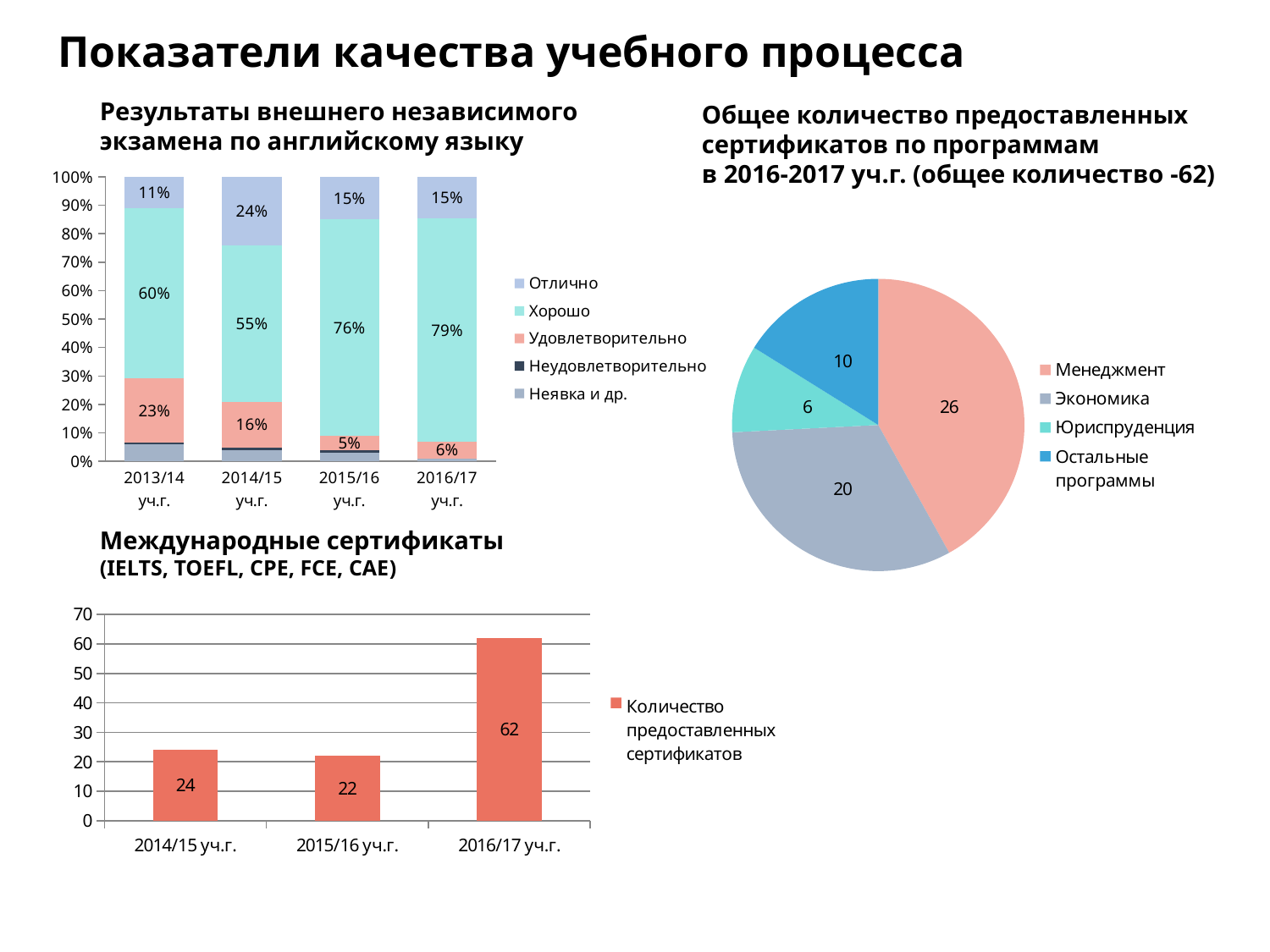
In the chart 'Результаты внешнего независимого экзамена по английскому языку', what is the difference between the 'Удовлетворительно' values for 2013/14 уч.г. and 2014/15 уч.г.? 7% In the pie chart 'Общее количество предоставленных сертификатов по программам', which program has the smallest slice? Юриспруденция In the chart 'Результаты внешнего независимого экзамена по английскому языку', what percentage is labelled 'Отлично' for 2014/15 уч.г.? 24% In the pie chart 'Общее количество предоставленных сертификатов по программам', which is larger: Менеджмент or Остальные программы? Менеджмент In the chart 'Международные сертификаты', what is the difference between the values for 2016/17 уч.г. and 2014/15 уч.г.? 38 In the chart 'Результаты внешнего независимого экзамена по английскому языку', what percentage is labelled 'Хорошо' for 2016/17 уч.г.? 79% In the chart 'Международные сертификаты', what is the value for 2015/16 уч.г.? 22 How many slices does the pie chart 'Общее количество предоставленных сертификатов по программам' have? 4 In the pie chart 'Общее количество предоставленных сертификатов по программам', what is the value for Экономика? 20 In the chart 'Результаты внешнего независимого экзамена по английскому языку', which year has the highest 'Хорошо' percentage? 2016/17 уч.г. How many series does the legend of the chart 'Результаты внешнего независимого экзамена по английскому языку' list? 5 What kind of chart is 'Результаты внешнего независимого экзамена по английскому языку'? Stacked bar chart